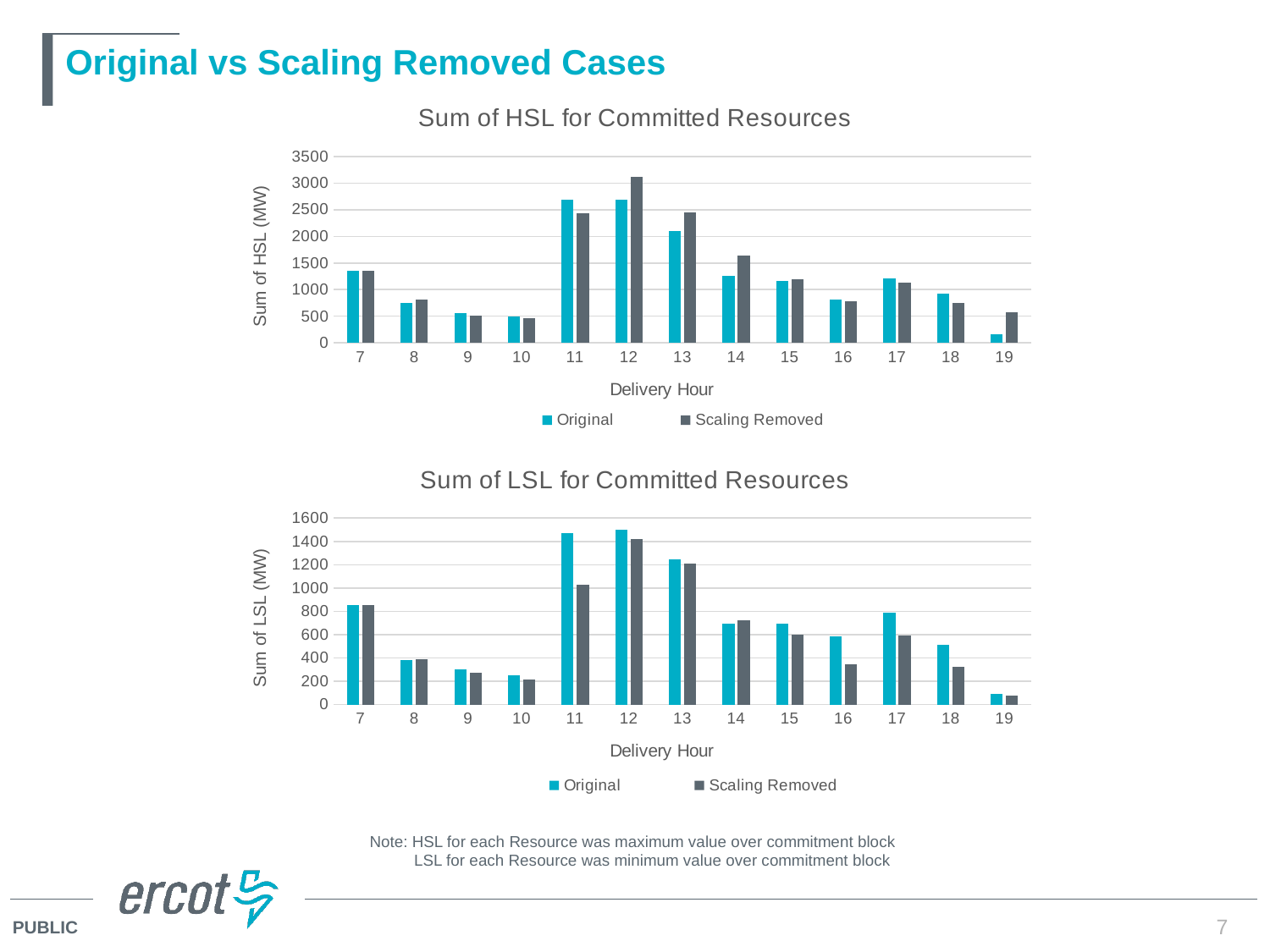
In the 'Sum of HSL for Committed Resources' chart, at delivery hour 14, which series has the larger value, Original or Scaling Removed? Scaling Removed In the 'Sum of HSL for Committed Resources' chart, which delivery hour has the highest Scaling Removed value? 12 How many series does the legend of the 'Sum of LSL for Committed Resources' chart list? 2 In the 'Sum of HSL for Committed Resources' chart, is the Original value for delivery hour 19 greater or less than 500? less How many delivery hours are shown on the x axis of the 'Sum of HSL for Committed Resources' chart? 13 In the 'Sum of LSL for Committed Resources' chart, at delivery hour 18, which series has the larger value, Original or Scaling Removed? Original In the 'Sum of HSL for Committed Resources' chart, which delivery hour has the lowest Original value? 19 In the 'Sum of HSL for Committed Resources' chart, is the Scaling Removed value for delivery hour 12 greater or less than 3000? greater In the 'Sum of LSL for Committed Resources' chart, which delivery hour has the highest Scaling Removed value? 12 In the 'Sum of LSL for Committed Resources' chart, is the Original value for delivery hour 11 greater or less than 1400? greater What type of chart is the 'Sum of LSL for Committed Resources' chart? Bar chart In the 'Sum of LSL for Committed Resources' chart, which delivery hour has the lowest Original value? 19